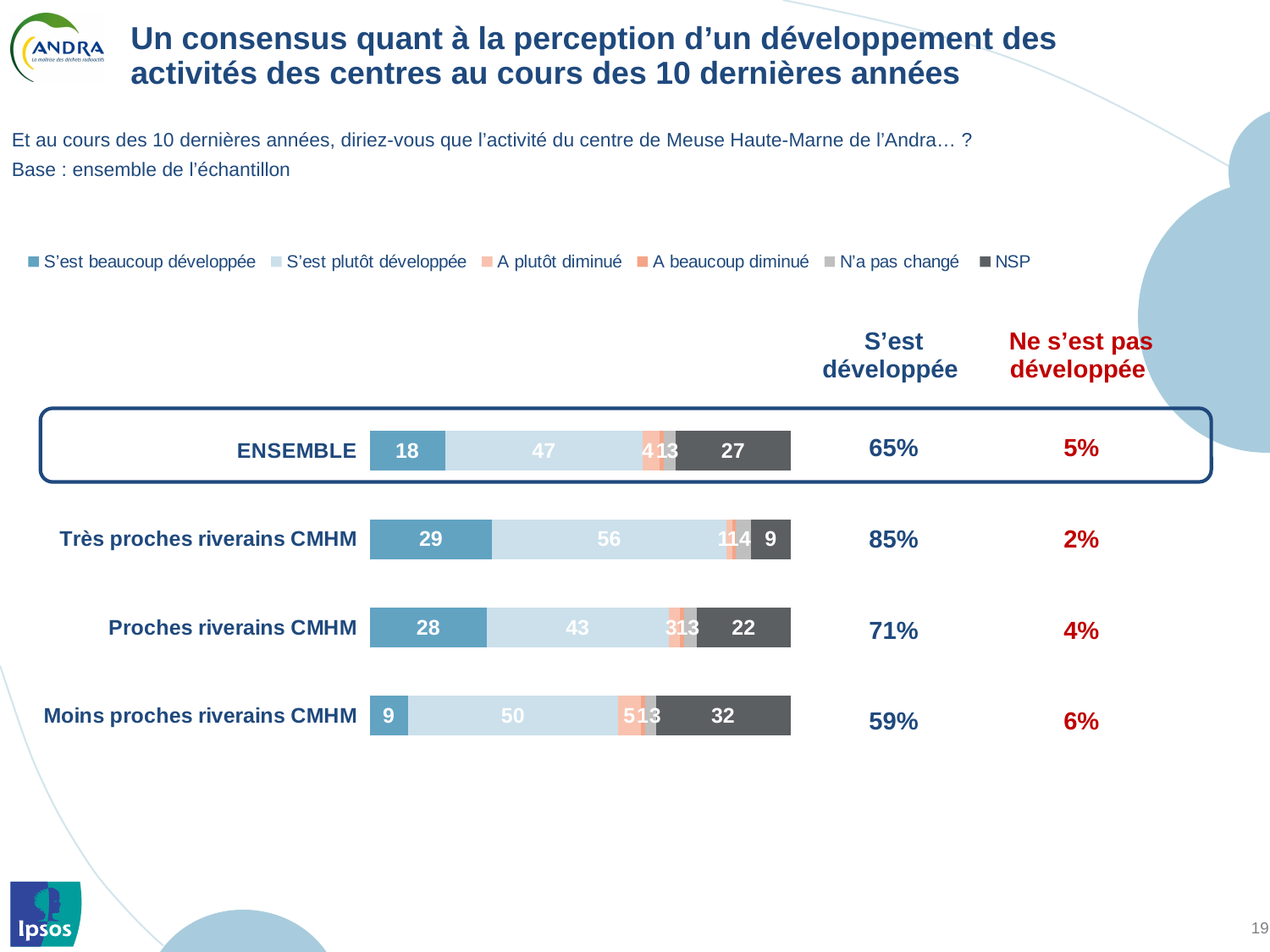
What kind of chart is shown on the slide? Stacked bar chart How many series does the legend list? 6 What is the "Ne s'est pas développée" percentage shown for Moins proches riverains CMHM? 6% Which category has the lowest value for "S'est beaucoup développée"? Moins proches riverains CMHM What is the difference between the NSP value for ENSEMBLE and the NSP value for Très proches riverains CMHM? 18 Which category has the lowest NSP value? Très proches riverains CMHM How many categories (bars) are shown in the chart? 4 What is the value for "S'est beaucoup développée" in the ENSEMBLE bar? 18 What is the value for "S'est plutôt développée" for Très proches riverains CMHM? 56 What is the "S'est développée" percentage shown for Proches riverains CMHM? 71% What is the NSP value for Moins proches riverains CMHM? 32 Which has a larger "S'est plutôt développée" value: Proches riverains CMHM or Moins proches riverains CMHM? Moins proches riverains CMHM